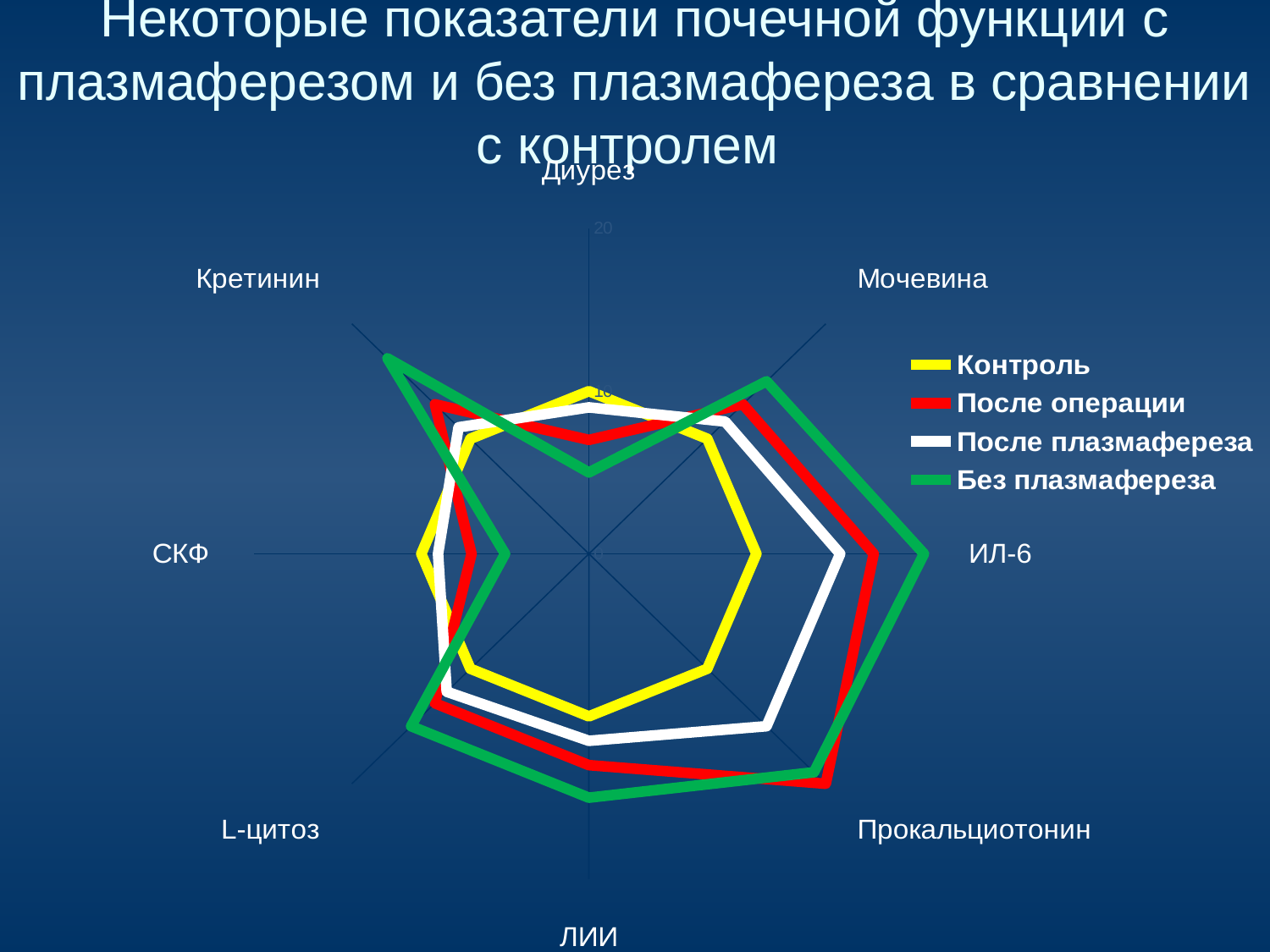
Which series has the lowest value for Прокальциотонин? Контроль Which series has the highest value for ИЛ-6? Без плазмафереза What kind of chart is shown on the slide? radar chart How many indicators (axes) are plotted on the radar chart? 8 Which series is drawn in green? Без плазмафереза Is the value of Без плазмафереза for СКФ greater or less than 10? less For ЛИИ, which is larger: the value for Без плазмафереза or the value for Контроль? Без плазмафереза Which series has the highest value for Кретинин? Без плазмафереза Which series has the lowest value for Диурез? Без плазмафереза Is the value of После операции for ИЛ-6 greater or less than 10? greater Which series is drawn in yellow? Контроль How many series does the legend list? 4